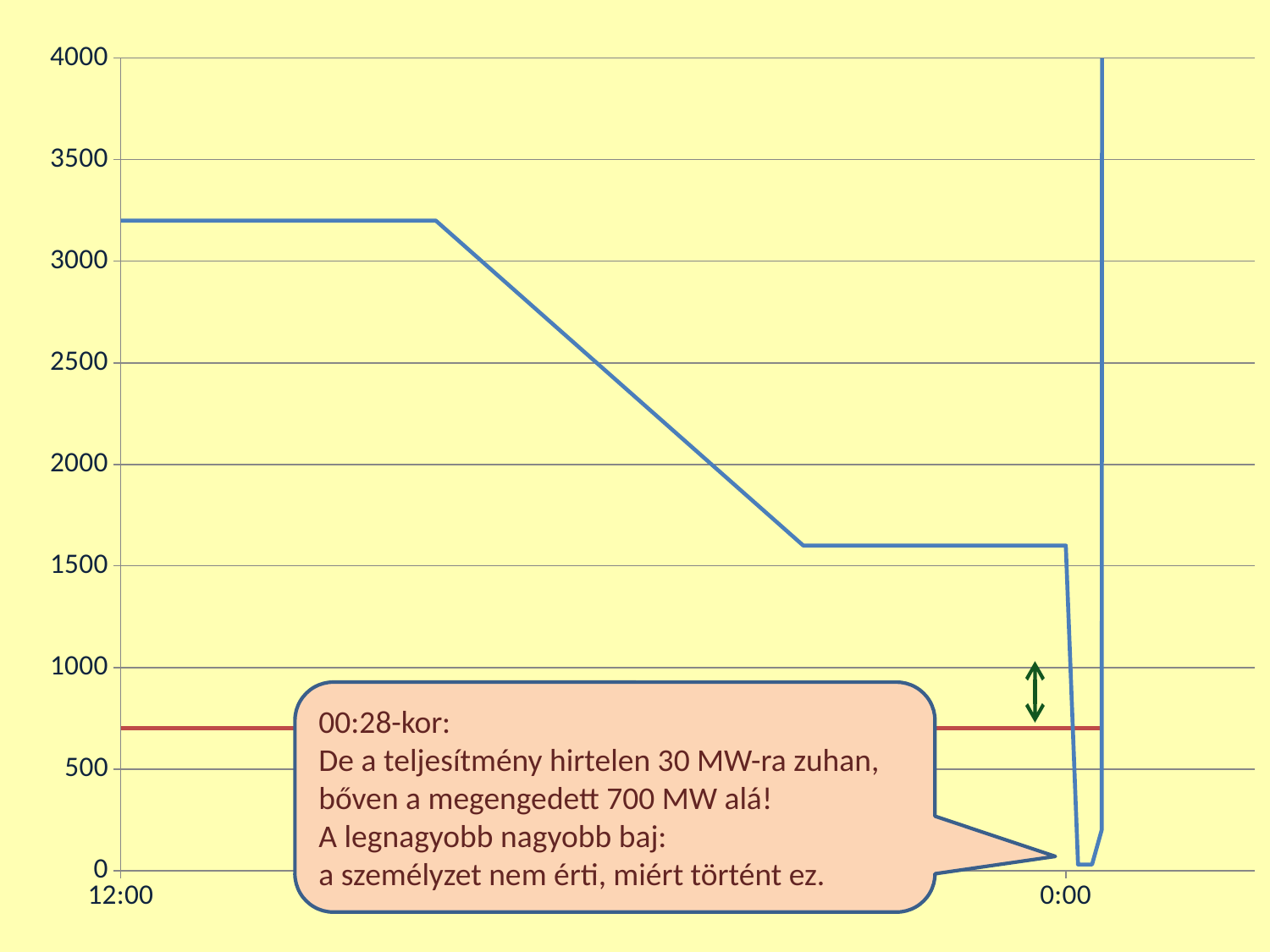
According to the callout, to what value does the power suddenly drop at 00:28? 30 MW Is the lowest point of the blue line shortly after 0:00 greater or less than 500? less Which is larger: the value of the blue line at 12:00 or its value just before 0:00? 12:00 Does the blue line rise or fall between 12:00 and 0:00? fall According to the callout, what is the permitted (allowed) power level marked by the red horizontal line? 700 MW Is the value of the blue line at 12:00 greater or less than 3000? greater Is the value of the blue line on the flat section just before 0:00 greater or less than 2000? less What two time labels are shown on the horizontal axis? 12:00 and 0:00 By how much is the 30 MW value below the permitted 700 MW level? 670 MW What is the highest value shown on the vertical axis? 4000 What kind of chart is shown on the slide? line chart